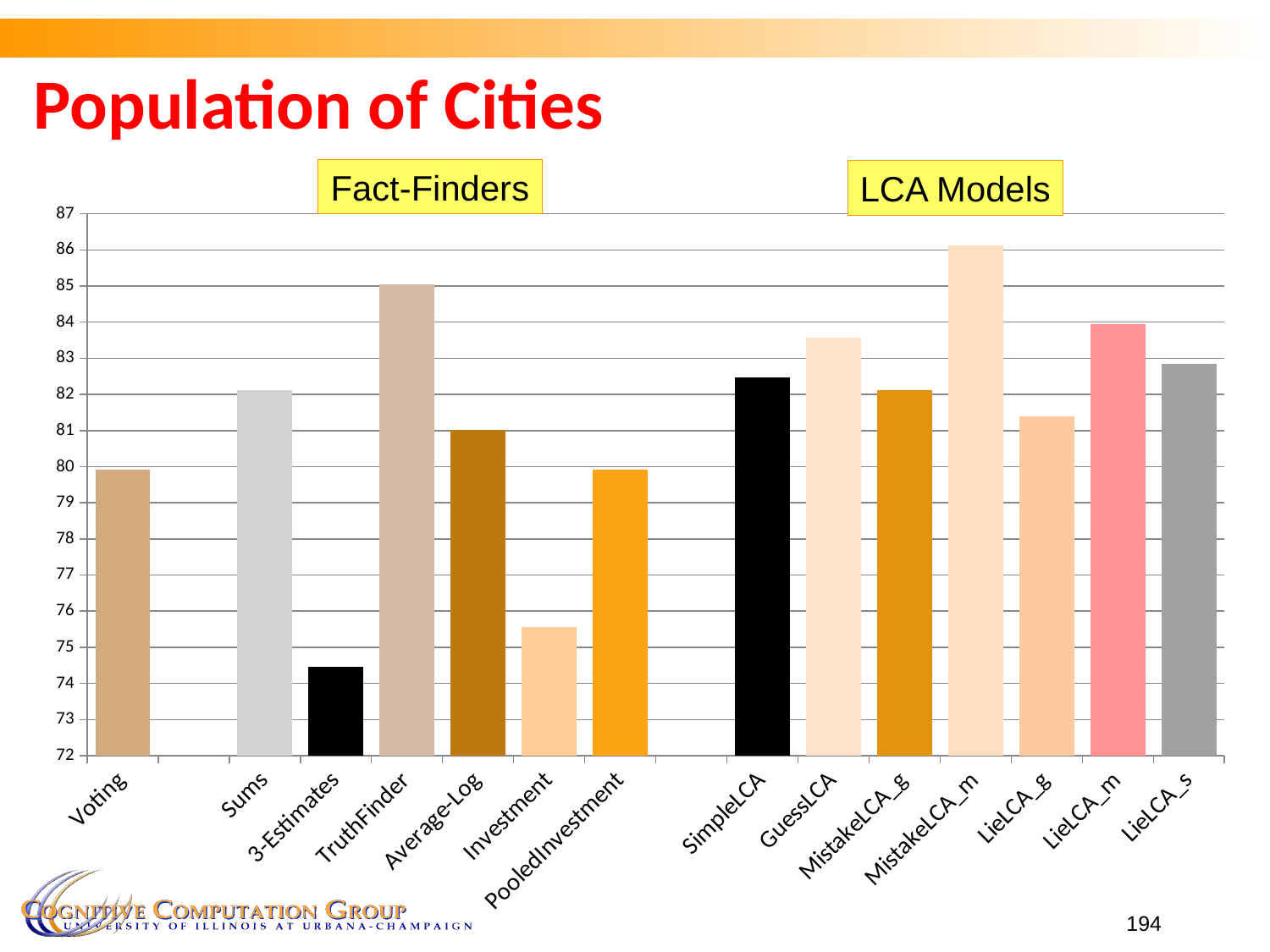
Is the value for TruthFinder greater or less than 84? greater Which is larger, the value for Investment or the value for PooledInvestment? PooledInvestment What kind of chart is shown on the slide? bar chart Which is larger, the value for TruthFinder or the value for Sums? TruthFinder Which is larger, the value for LieLCA_m or the value for LieLCA_g? LieLCA_m Is the value for 3-Estimates greater or less than 75? less How many categories (bars) are plotted in the chart? 14 Is the value for Investment greater or less than 76? less Which category has the lowest value in the chart? 3-Estimates Which category has the highest value in the chart? MistakeLCA_m What is the title of the slide containing the chart? Population of Cities